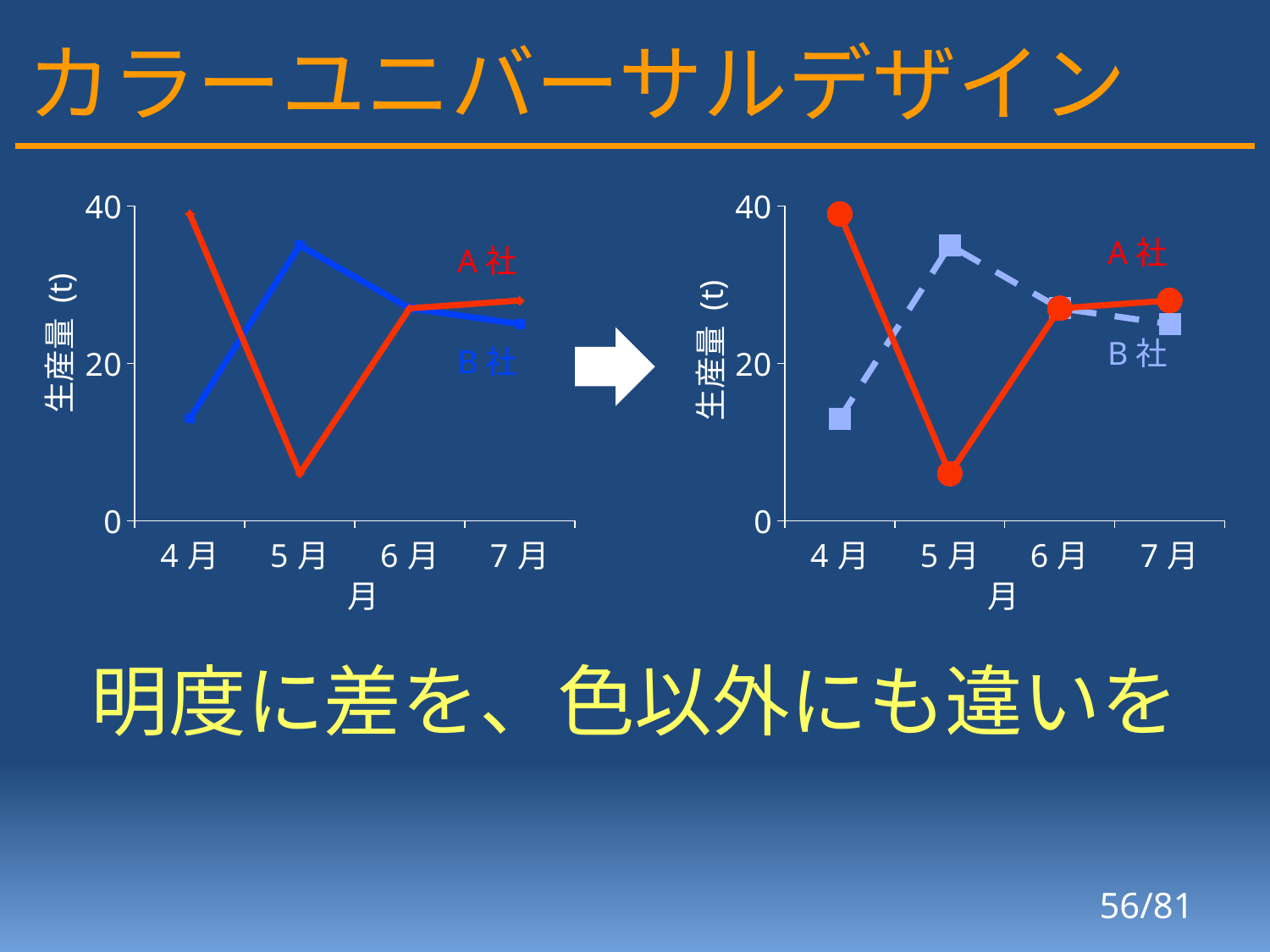
In the left chart, is the value for A社 in 5月 greater or less than 20? less What is the y-axis label of the left chart? 生産量 (t) In the right chart, does the A社 line rise or fall from 4月 to 5月? fall In the left chart, how many months are shown on the x axis? 4 In the right chart, how many series are plotted? 2 In the right chart, what marker shape is used for the B社 series? squares In the left chart, is the value for A社 in 4月 greater or less than 20? greater What kind of chart is the left chart? line chart In the left chart, which series has the larger value in 5月, A社 or B社? B社 In the right chart, is the value for B社 in 4月 greater or less than 20? less In the right chart, in which month is A社 highest? 4月 In the left chart, in which month is B社 lowest? 4月